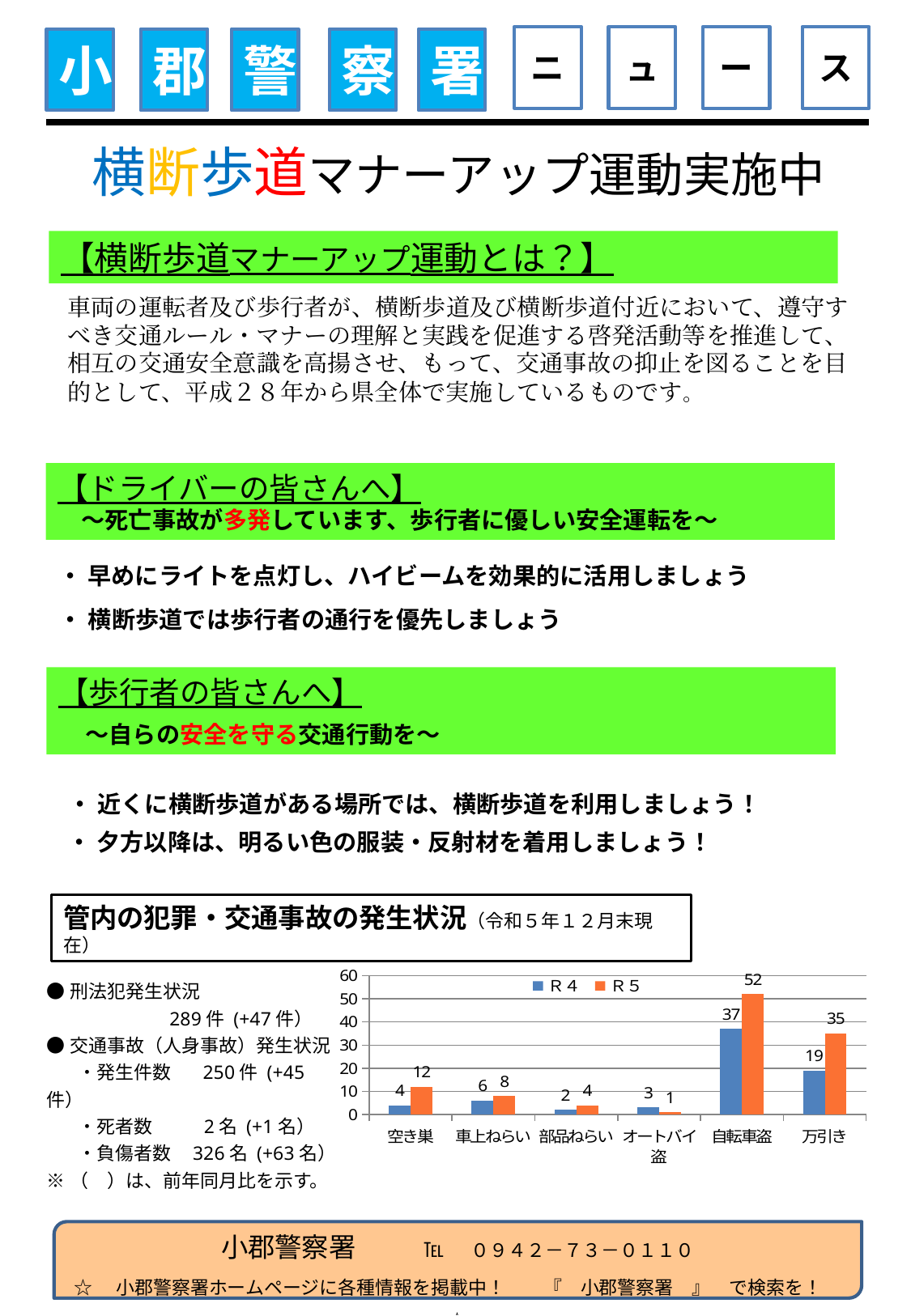
Is the R5 value for 万引き greater or less than 30? greater What is the R5 value for 自転車盗? 52 What is the R4 value for 万引き? 19 How many categories are shown on the x axis of the chart? 6 Which category has the lowest R4 value? 部品ねらい What is the difference between the R5 and R4 values for 自転車盗? 15 Which category has the highest R5 value? 自転車盗 How many series does the chart legend list? 2 What are the two series names in the chart legend? R４ and R５ What kind of chart is shown on the slide? bar chart What is the R5 value for 空き巣? 12 For オートバイ盗, which is larger, the R4 value or the R5 value? R4